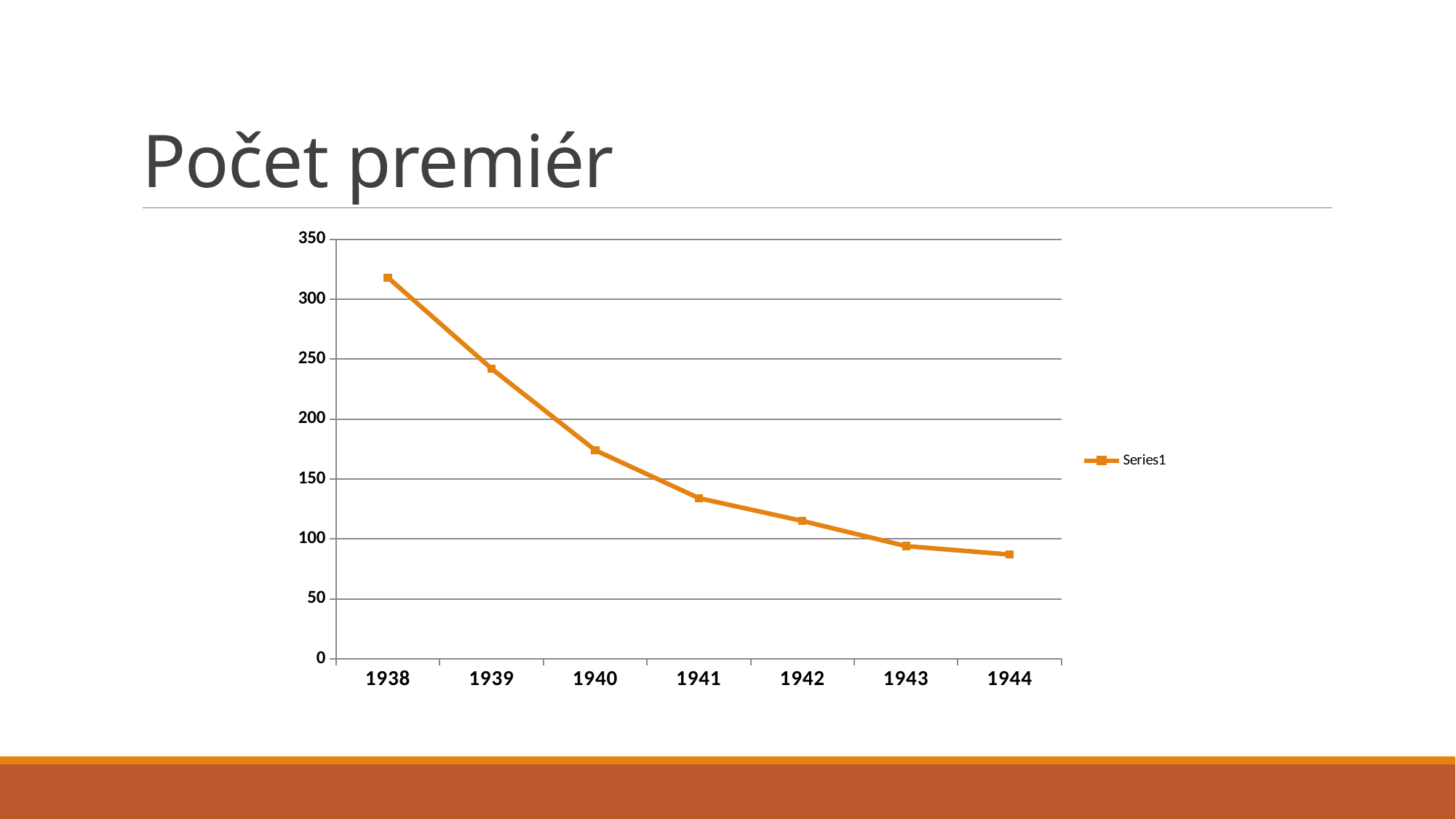
Is the value for 1944 greater or less than 100? less Do the values rise or fall from 1938 to 1944? fall Which year has the highest value? 1938 Which year has the lowest value? 1944 Is the value for 1938 greater or less than 300? greater What is the title of the slide containing the chart? Počet premiér Is the value for 1940 greater or less than 200? less How many series does the legend list? 1 How many years are plotted on the x axis? 7 What type of chart is shown on the slide? line chart Which is larger, the value for 1940 or the value for 1942? 1940